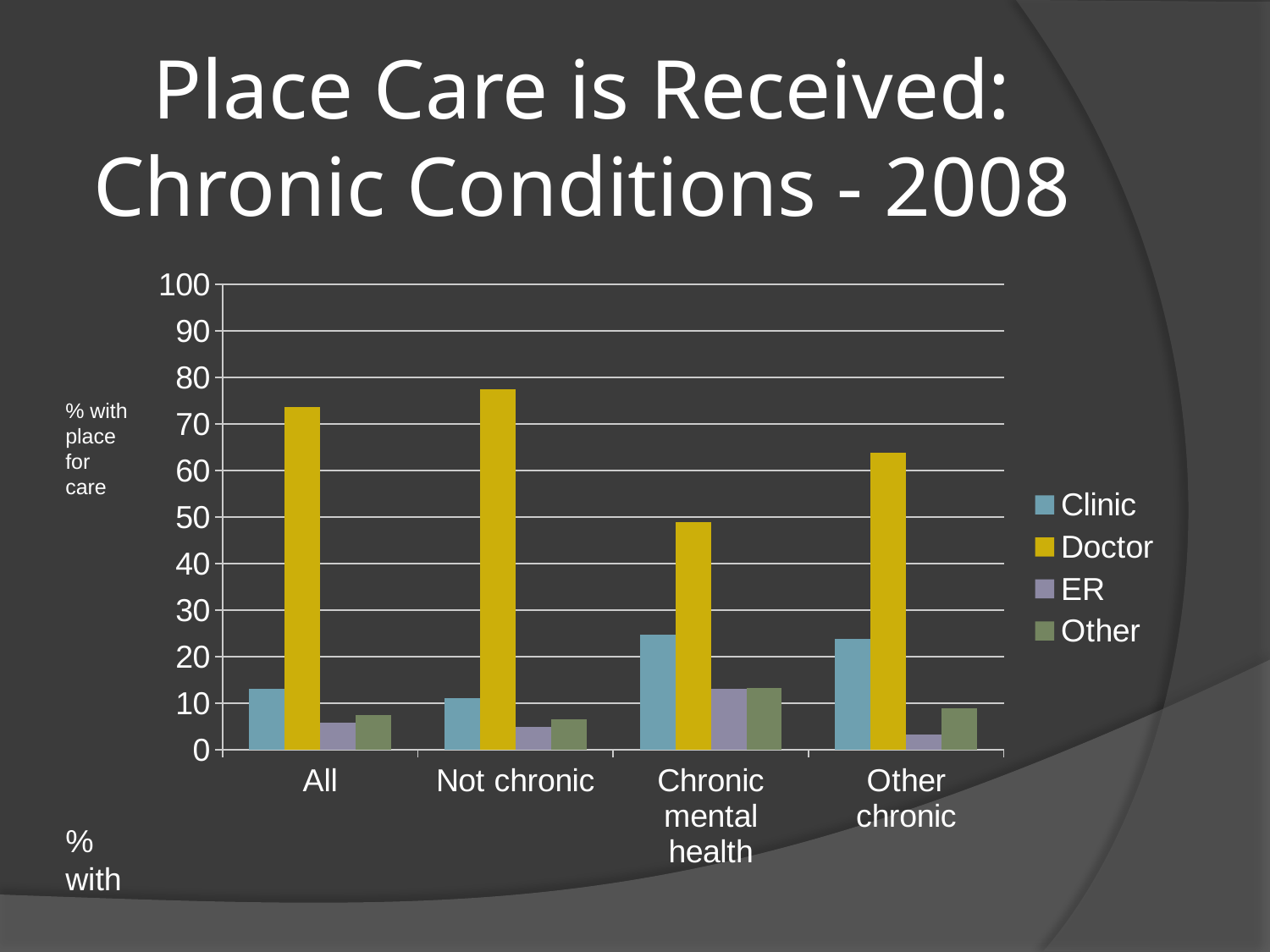
How many series does the legend list? 4 Is the Doctor value for Chronic mental health greater or less than 60? less Is the Clinic value for Chronic mental health greater or less than 20? greater Which series has the lowest value for Other chronic? ER Is the Doctor value for All greater or less than 70? greater Which is larger, the ER value for Chronic mental health or the ER value for Other chronic? Chronic mental health Which category has the lowest Doctor bar? Chronic mental health How many categories are shown on the x axis? 4 Which is larger, the Clinic value for Chronic mental health or the Clinic value for All? Chronic mental health Which category has the highest Doctor bar? Not chronic What are the four legend entries of the chart? Clinic, Doctor, ER, Other What kind of chart is shown on the slide? bar chart